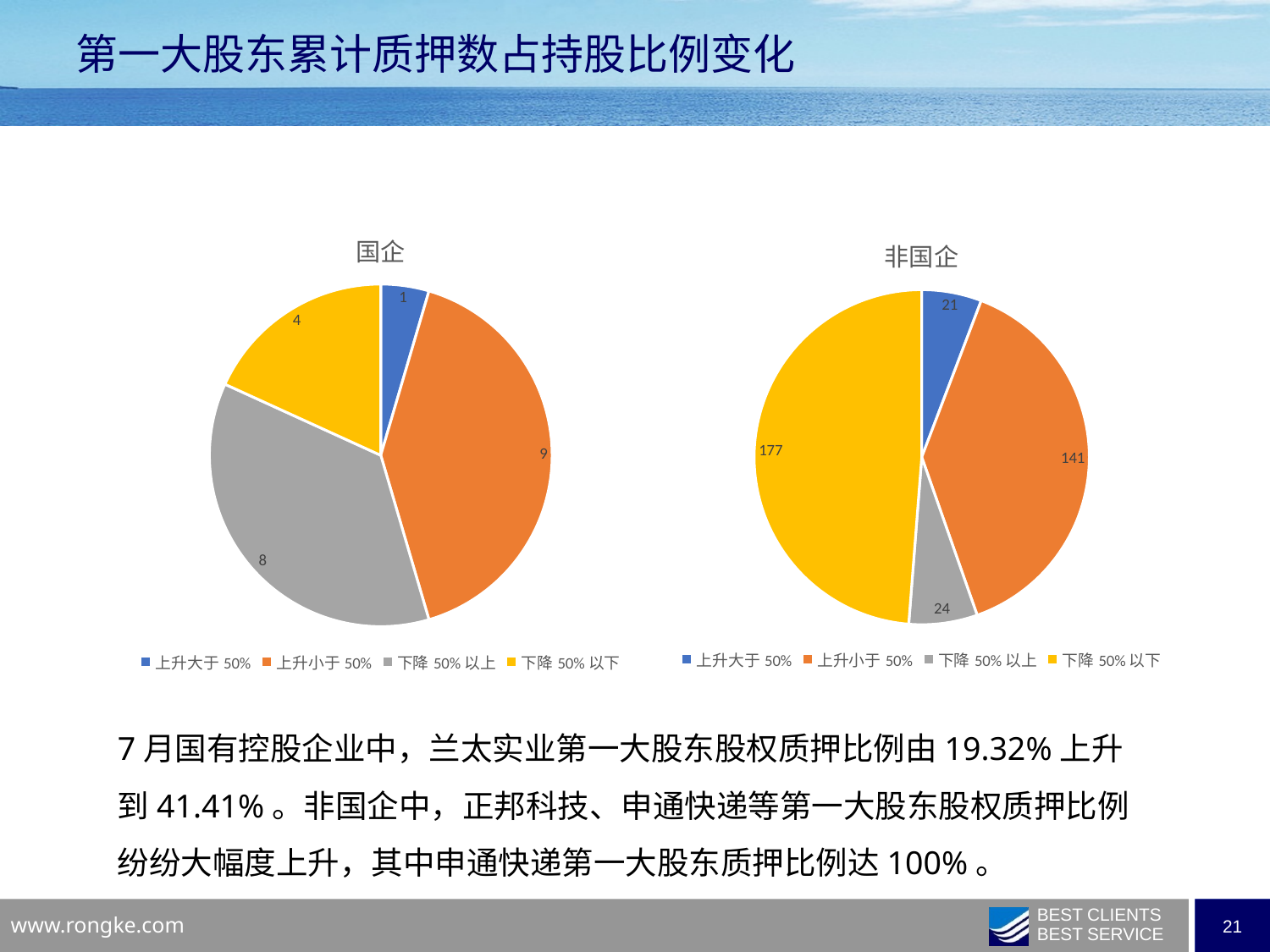
In the 国企 pie chart, which is larger: 下降 50% 以上 or 下降 50% 以下? 下降 50% 以上 In the 国企 pie chart, which category has the largest slice? 上升小于 50% In the 非国企 pie chart, what is the value for 下降 50% 以下? 177 In the 非国企 pie chart, which category has the largest slice? 下降 50% 以下 What is the title of the pie chart on the right side of the slide? 非国企 In the 非国企 pie chart, what is the difference between 下降 50% 以下 and 上升小于 50%? 36 In the 国企 pie chart, which category has the smallest slice? 上升大于 50% In the 非国企 pie chart, what is the value for 上升大于 50%? 21 What type of chart is used for 国企 and 非国企 on this slide? Pie chart In the 国企 pie chart, what is the value for 上升小于 50%? 9 How many categories does the 非国企 pie chart show? 4 What is the total of all slices in the 国企 pie chart? 22